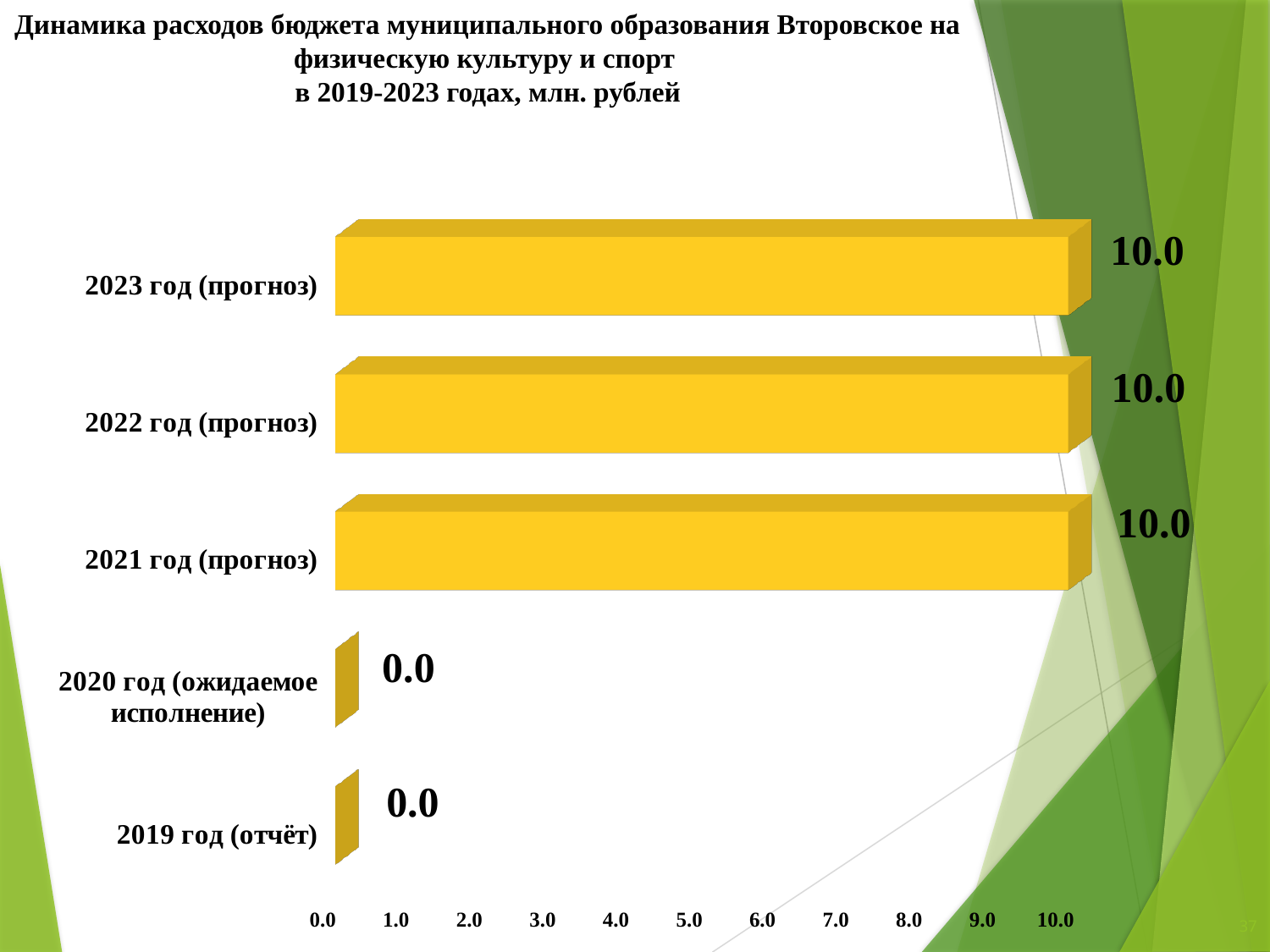
What is the difference between the values for 2022 год (прогноз) and 2020 год (ожидаемое исполнение)? 10.0 What is the highest tick value shown on the horizontal axis? 10.0 What is the value for 2019 год (отчёт)? 0.0 Do the values rise or fall from 2019 to 2023? rise What is the value for 2020 год (ожидаемое исполнение)? 0.0 What kind of chart is shown on the slide? bar chart Is the value for 2022 год (прогноз) greater or less than 5.0? greater What is the value for 2021 год (прогноз)? 10.0 How many categories are shown in the chart? 5 Which is larger, the value for 2021 год (прогноз) or the value for 2019 год (отчёт)? 2021 год (прогноз) How many categories have a value of 10.0? 3 What is the value for 2023 год (прогноз)? 10.0